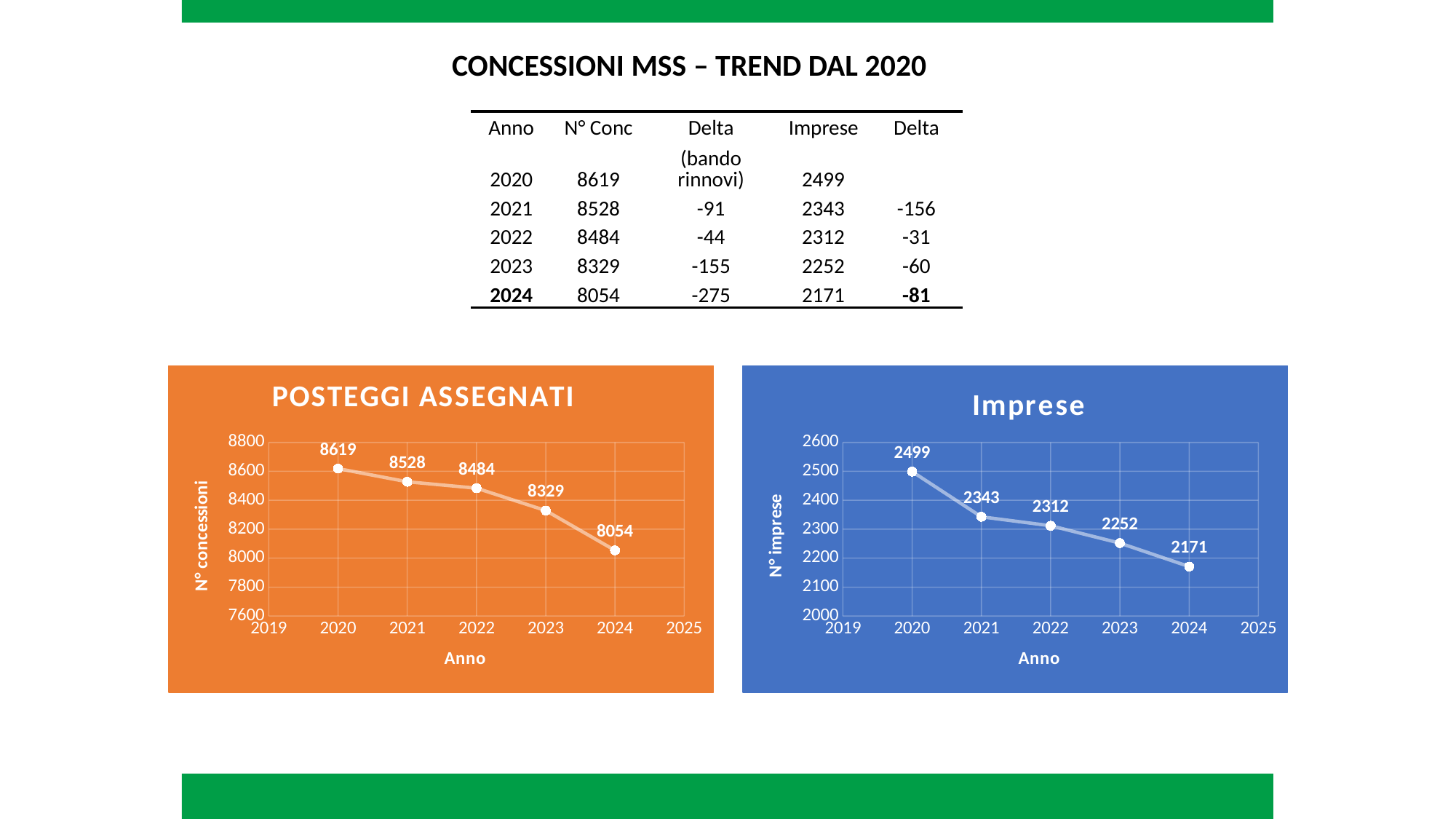
In the POSTEGGI ASSEGNATI chart, what is the difference between the 2023 and 2024 values? 275 In the Imprese chart, do the values rise or fall from 2020 to 2024? fall In the Imprese chart, what is the value for 2022? 2312 In the Imprese chart, is the value for 2021 larger or smaller than the value for 2023? larger In the POSTEGGI ASSEGNATI chart, which year has the highest value? 2020 In the POSTEGGI ASSEGNATI chart, what is the value for 2020? 8619 What kind of chart is the POSTEGGI ASSEGNATI chart? line chart In the Imprese chart, which year has the lowest value? 2024 In the POSTEGGI ASSEGNATI chart, what is the value for 2024? 8054 In the Imprese chart, what is the difference between the 2020 and 2021 values? 156 How many data points are plotted in the Imprese chart? 5 In the POSTEGGI ASSEGNATI chart, is the value for 2022 greater or less than 8400? greater